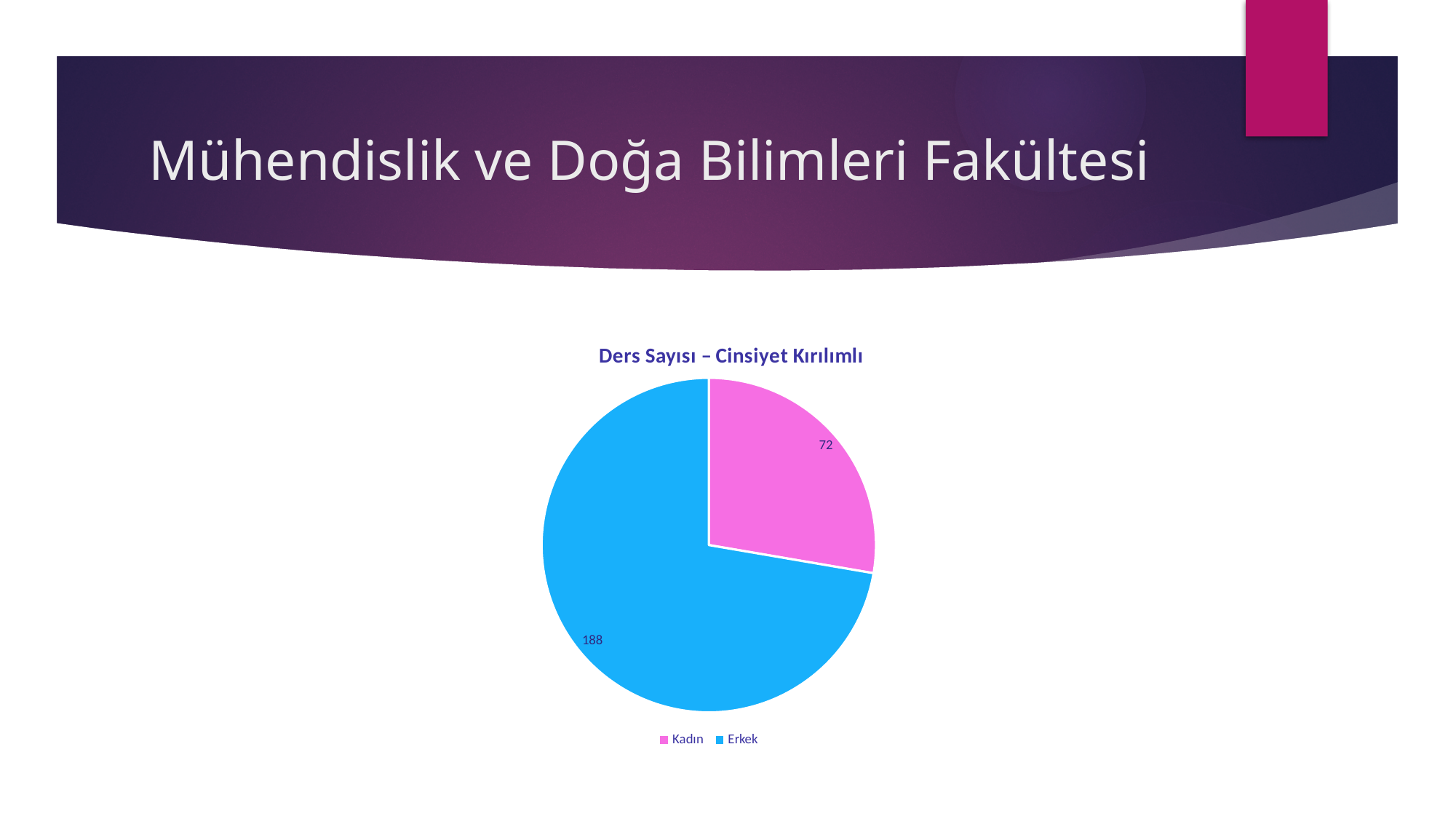
Which colour represents Erkek in the pie chart? Blue How many categories does the pie chart show? 2 What kind of chart is shown on the slide? Pie chart What is the total of the two values in the pie chart? 260 Which category has the smallest slice of the pie chart? Kadın What is the title of the chart? Ders Sayısı – Cinsiyet Kırılımlı What is the value for Erkek in the pie chart? 188 Which category has the largest slice of the pie chart? Erkek What is the difference between the Erkek and Kadın values? 116 Which is larger, the value for Kadın or the value for Erkek? Erkek What is the value for Kadın in the pie chart? 72